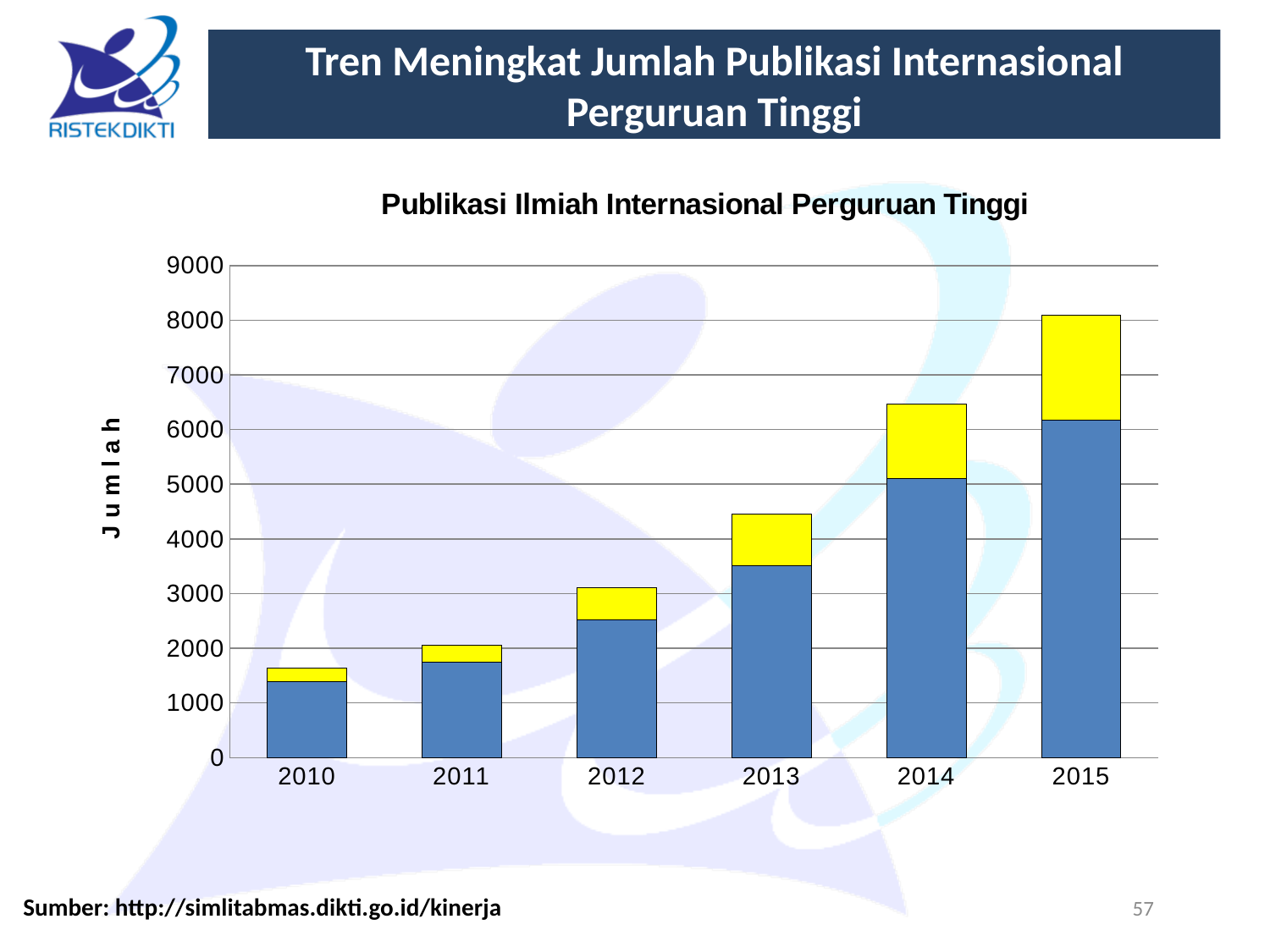
Is the total bar height for 2015 greater or less than 7000? greater Do the bar totals rise or fall from 2010 to 2015? rise Is the total bar for 2014 taller or shorter than the total bar for 2012? taller Is the total bar height for 2013 greater or less than 5000? less What label is shown on the vertical axis of the chart? J u m l a h Which year has the shortest bar in the chart? 2010 Is the total bar height for 2014 greater or less than 6000? greater What is the title of the chart? Publikasi Ilmiah Internasional Perguruan Tinggi What kind of chart is shown on the slide? bar chart Which year has the tallest bar in the chart? 2015 How many years are shown on the x axis of the chart? 6